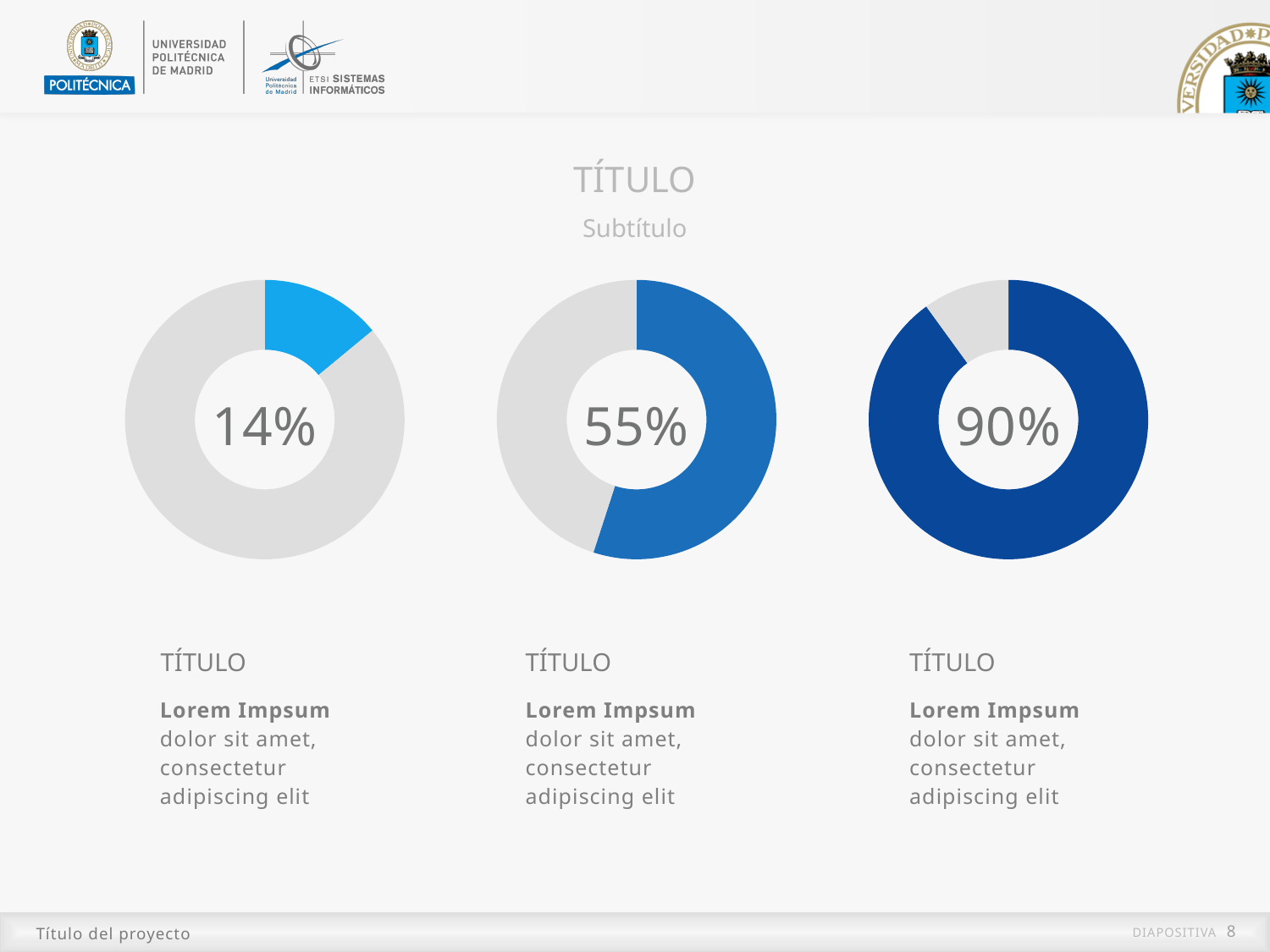
Which of the three donut charts shows the lowest percentage: left, middle or right? left What colour is the filled segment of the left donut chart? light blue What value is shown in the centre of the left donut chart? 14% What kind of chart is used for the three figures on the slide? donut chart What is the difference between the percentage in the right donut chart and the percentage in the left donut chart? 76% How many donut charts are on the slide? 3 Which is larger, the percentage in the middle donut chart or the percentage in the left donut chart? middle What value is shown in the centre of the right donut chart? 90% What is the difference between the percentage in the middle donut chart and the percentage in the left donut chart? 41% Which of the three donut charts shows the highest percentage: left, middle or right? right In the right donut chart, what share of the ring is filled with the dark blue colour? 90% What value is shown in the centre of the middle donut chart? 55%